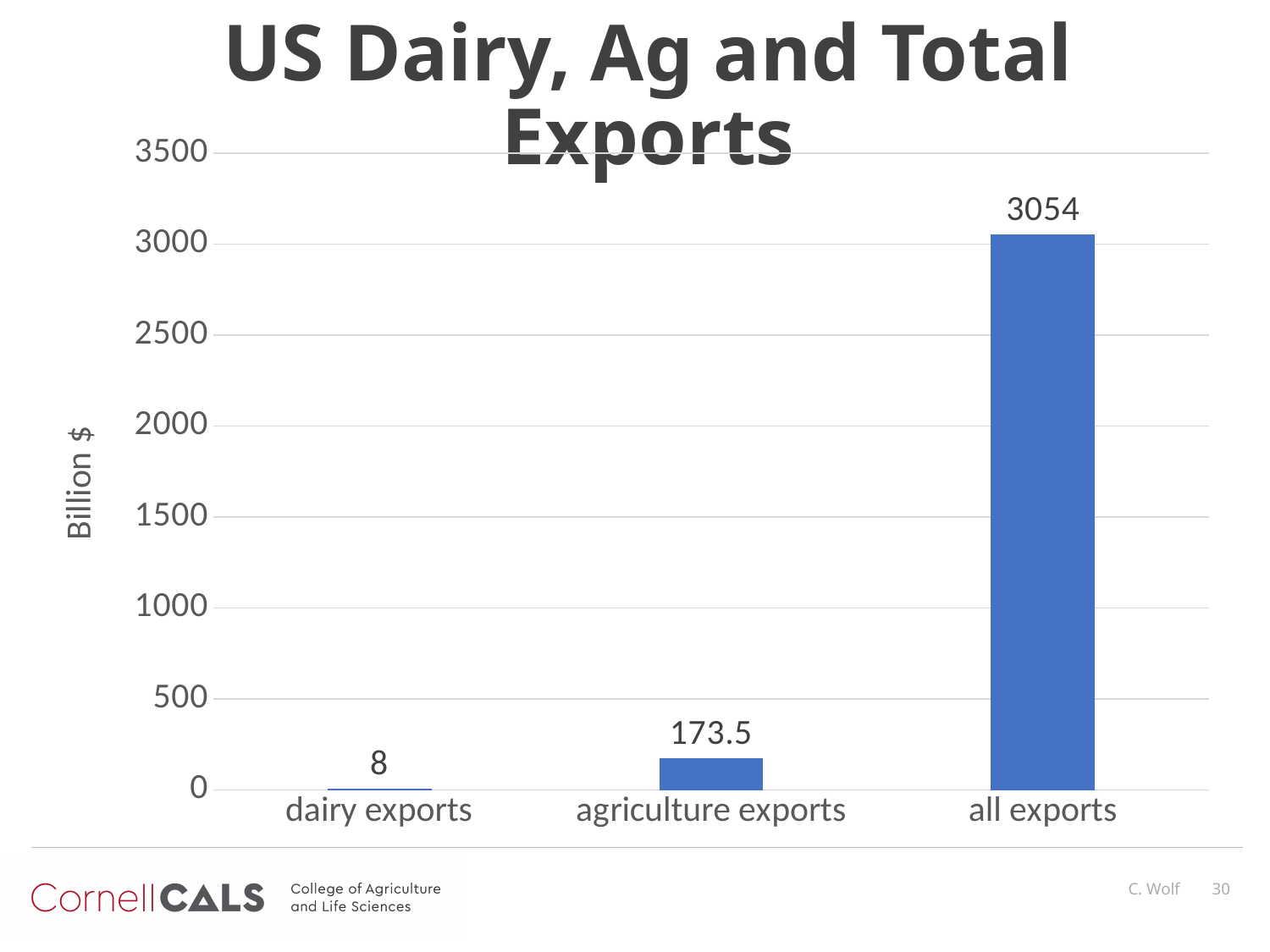
What is the value for agriculture exports? 173.5 Which is larger, agriculture exports or dairy exports? agriculture exports What is the difference between all exports and agriculture exports? 2880.5 Is the value for all exports greater or less than 3000? greater How many categories are shown on the chart? 3 What is the value for dairy exports? 8 Which category has the lowest value? dairy exports What kind of chart is shown on the slide? bar chart Which category has the highest value? all exports What is the label on the vertical axis? Billion $ What is the difference between agriculture exports and dairy exports? 165.5 What is the value for all exports? 3054